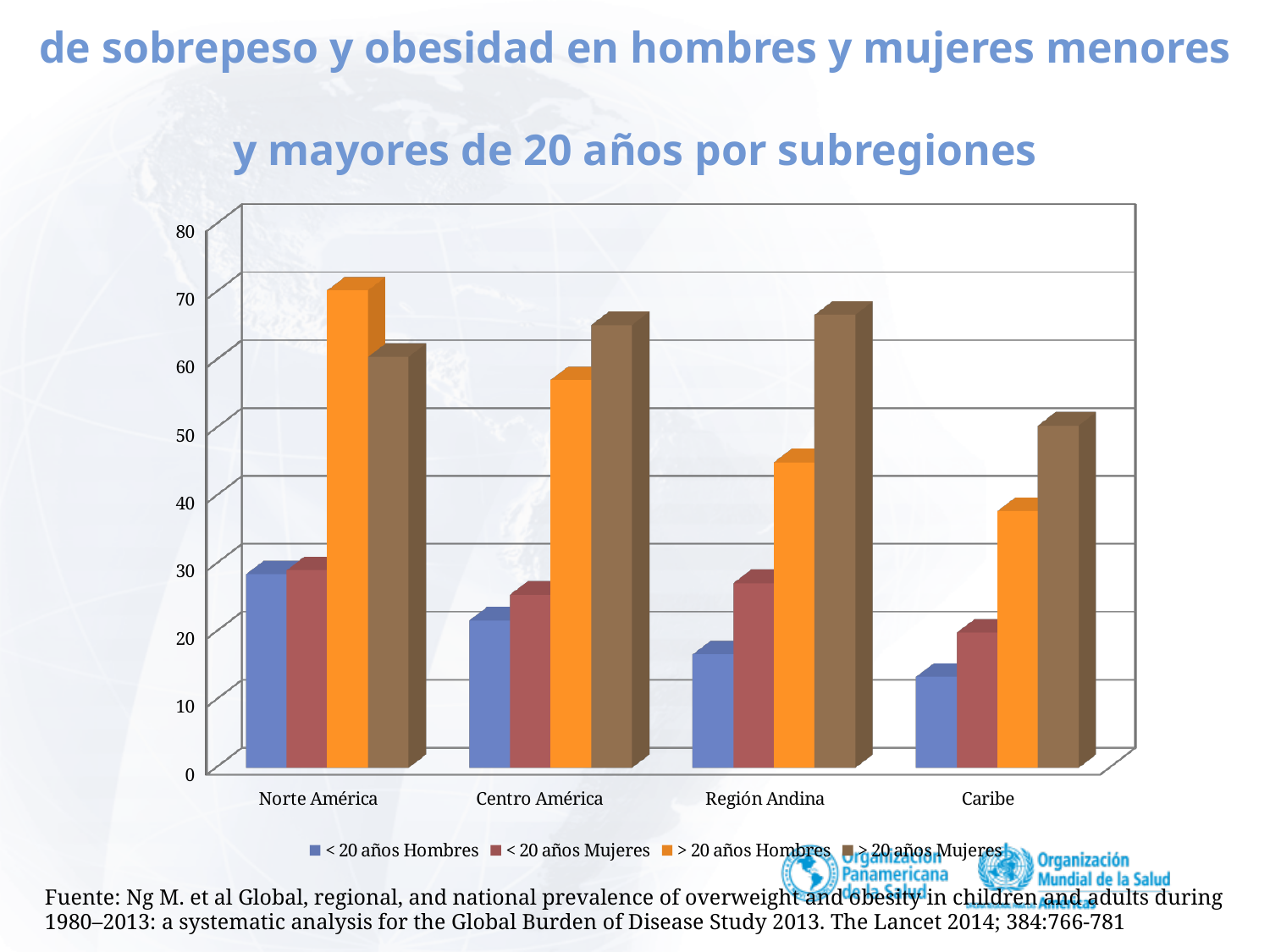
Do the values for '< 20 años Hombres' rise or fall from Norte América to Caribe along the x axis? fall How many subregions are shown on the x axis of the chart? 4 Which subregion has the lowest value for '< 20 años Hombres'? Caribe Which subregion has the lowest value for '> 20 años Hombres'? Caribe Is the value for '> 20 años Hombres' in Norte América greater or less than 60? greater In Centro América, which is larger: '> 20 años Hombres' or '> 20 años Mujeres'? > 20 años Mujeres Is the value for '< 20 años Hombres' in Caribe greater or less than 20? less Which subregion has the highest value for '> 20 años Hombres'? Norte América How many series does the chart's legend list? 4 Is the value for '> 20 años Mujeres' in Región Andina greater or less than 60? greater What kind of chart is shown on the slide? bar chart Which series is shown in orange in the chart's legend? > 20 años Hombres